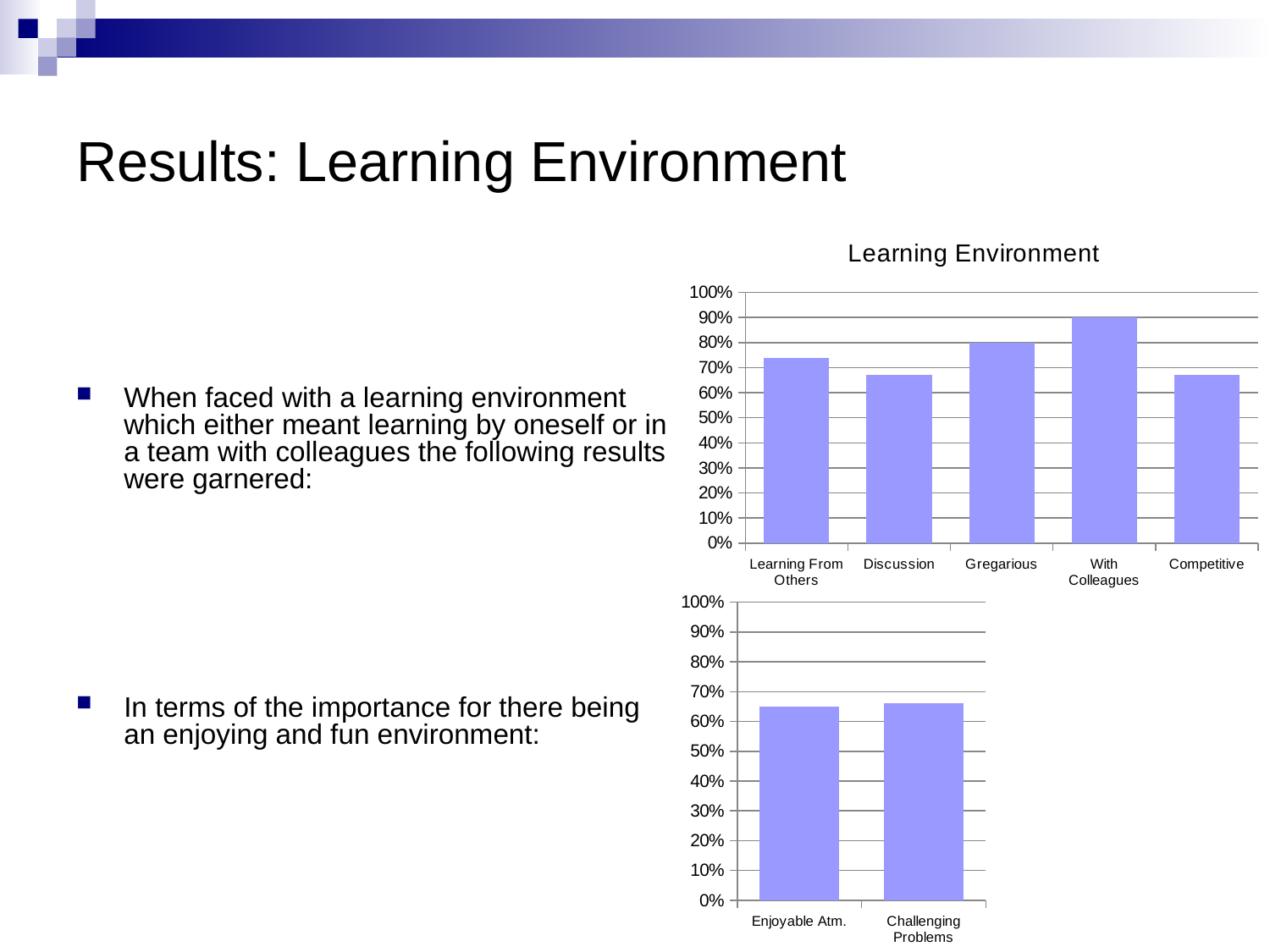
In the 'Learning Environment' chart, what is the value for With Colleagues? 90% In the 'Learning Environment' chart, is the value for Learning From Others greater or less than 70%? greater In the 'Learning Environment' chart, which is larger: Gregarious or Competitive? Gregarious In the lower chart on the right, is the value for Enjoyable Atm. greater or less than 60%? greater In the 'Learning Environment' chart, what is the difference between the values for With Colleagues and Gregarious? 10% How many categories are shown in the 'Learning Environment' chart? 5 In the 'Learning Environment' chart, which category has the highest value? With Colleagues In the lower chart on the right, is the value for Challenging Problems greater or less than 70%? less In the 'Learning Environment' chart, what is the value for Gregarious? 80% What kind of chart is the 'Learning Environment' chart at the top right of the slide? bar chart How many categories are shown in the lower chart on the right of the slide? 2